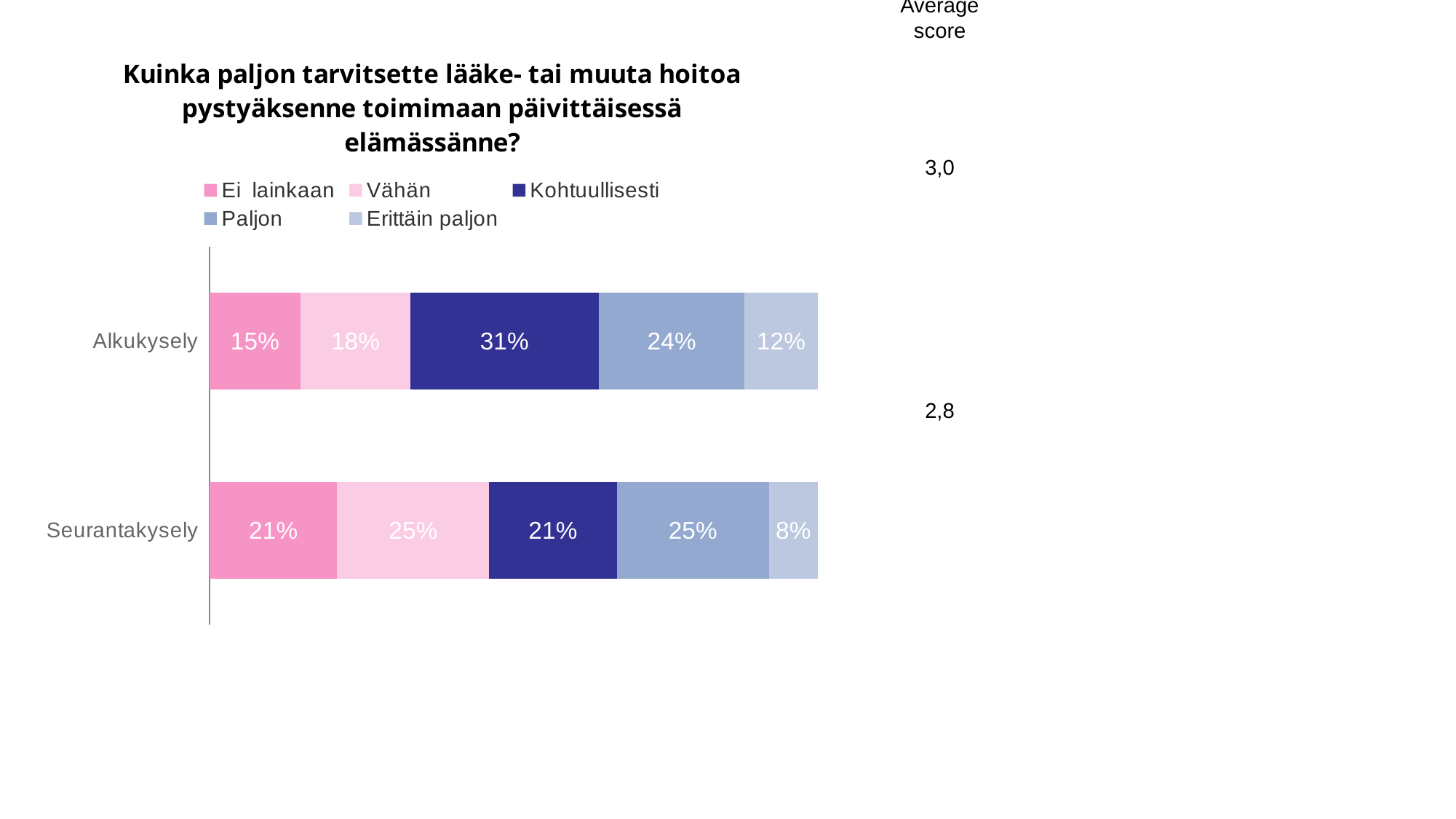
How many series does the legend list? 5 Which series has the highest value in the Alkukysely bar? Kohtuullisesti Which is larger: "Ei lainkaan" for Alkukysely or "Ei lainkaan" for Seurantakysely? Seurantakysely What is the value for "Kohtuullisesti" in the Alkukysely bar? 31% How many categories (bars) are shown on the chart? 2 What is the value for "Erittäin paljon" in the Alkukysely bar? 12% What is the value for "Vähän" in the Seurantakysely bar? 25% What is the difference between the "Kohtuullisesti" values for Alkukysely and Seurantakysely? 10 percentage points What kind of chart is shown on the slide? Stacked bar chart Which series has the lowest value in the Seurantakysely bar? Erittäin paljon What is the average score shown for Seurantakysely? 2,8 What is the value for "Ei lainkaan" in the Seurantakysely bar? 21%